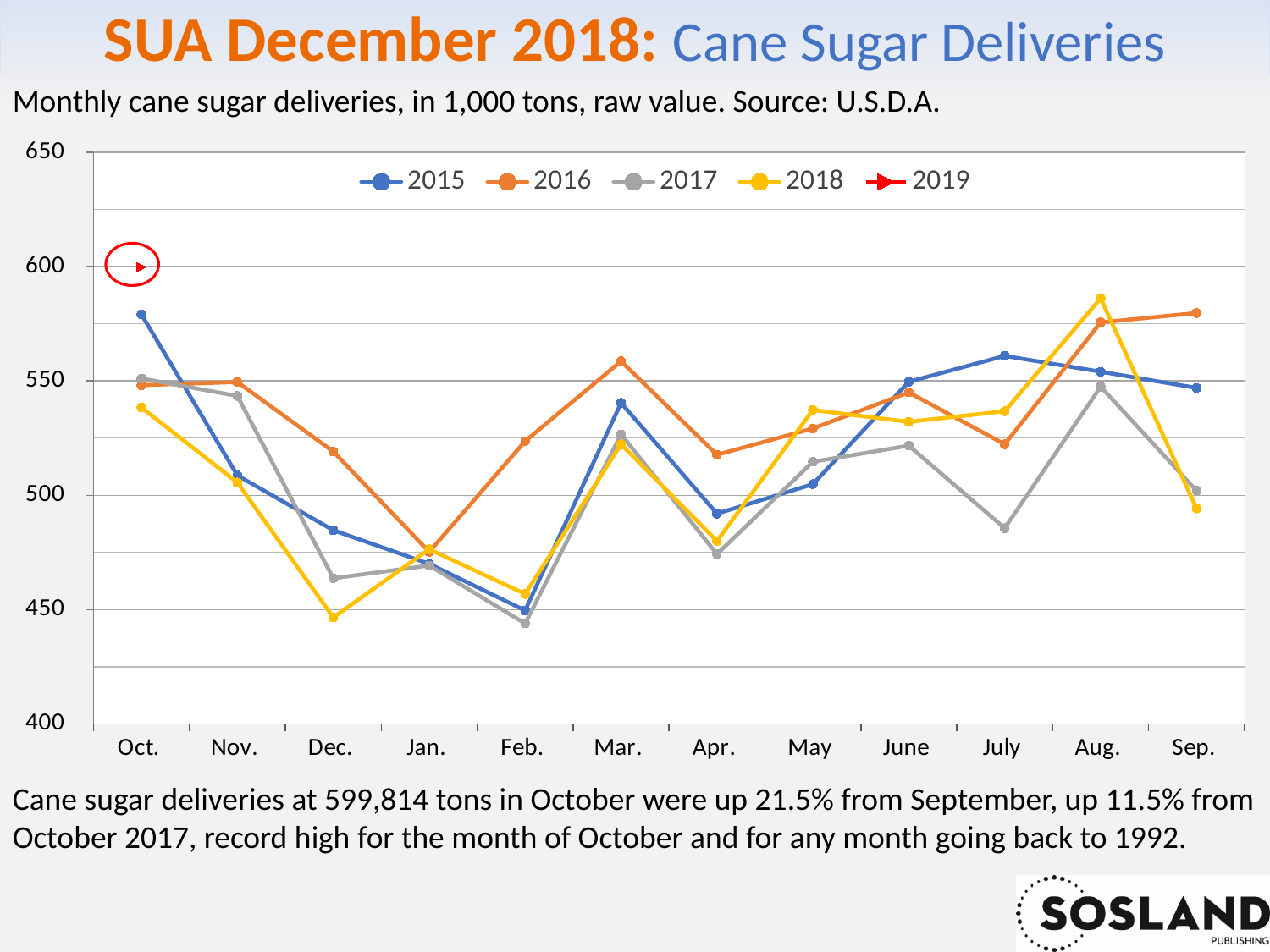
How many series does the legend list? 5 Which month has the lowest value for the 2017 series? Feb. Is the value for 2015 in Oct. greater or less than 550? greater What colour is the 2019 series in the legend? Red Which is larger in Sep., the 2016 value or the 2018 value? 2016 Which is larger in Oct., the 2015 value or the 2018 value? 2015 Does the 2018 series rise or fall from Oct. to Dec.? Fall Which month has the highest value for the 2018 series? Aug. How many months are shown along the x axis? 12 Is the value for 2017 in Dec. greater or less than 500? less Which month has the highest value for the 2015 series? Oct. What kind of chart is shown on the slide? Line chart